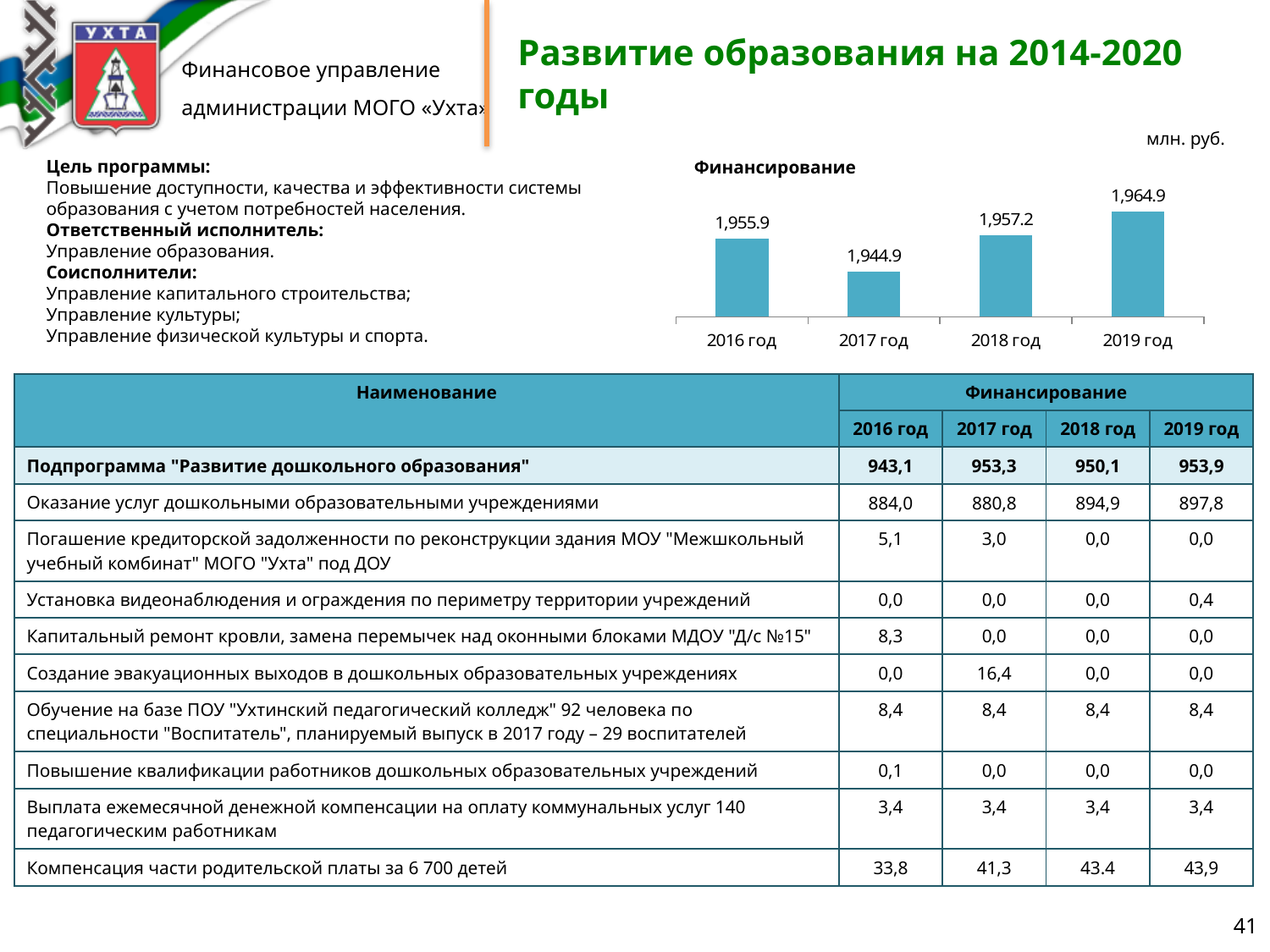
How many years are shown in the Финансирование chart? 4 Which year has the highest value in the Финансирование chart? 2019 год What is the value for 2018 год in the Финансирование chart? 1,957.2 Which year has the lowest value in the Финансирование chart? 2017 год What is the difference between the values for 2019 год and 2017 год in the Финансирование chart? 20.0 In the Финансирование chart, which is larger: the value for 2016 год or 2018 год? 2018 год What is the value for 2016 год in the Финансирование chart? 1,955.9 In the Финансирование chart, do the values rise or fall from 2017 год to 2019 год? rise What kind of chart is the Финансирование chart? bar chart What is the value for 2017 год in the Финансирование chart? 1,944.9 What is the difference between the values for 2016 год and 2017 год in the Финансирование chart? 11.0 What is the value for 2019 год in the Финансирование chart? 1,964.9